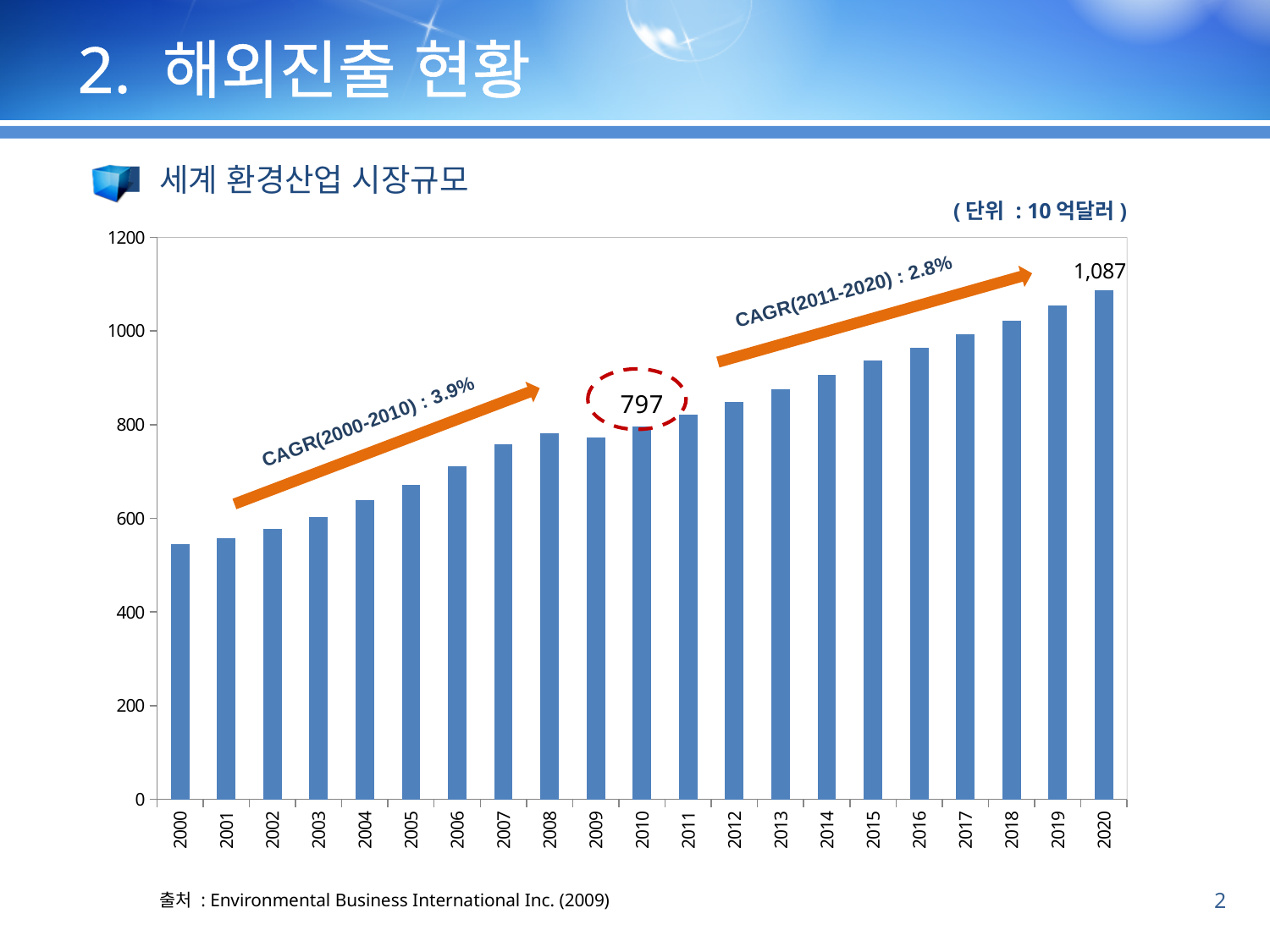
Is the value for 2015 greater or less than 1000? less What is the difference between the values for 2020 and 2010? 290 Is the value for 2000 greater or less than 600? less How many years are shown on the x axis? 21 What is the value for 2020? 1,087 What is the value for 2010? 797 Which year has the highest value? 2020 Which is larger, the value for 2010 or the value for 2020? 2020 Is the value for 2019 greater or less than 1000? greater Do the values rise or fall from 2000 to 2020? rise Which year has the lowest value? 2000 What kind of chart is shown? bar chart